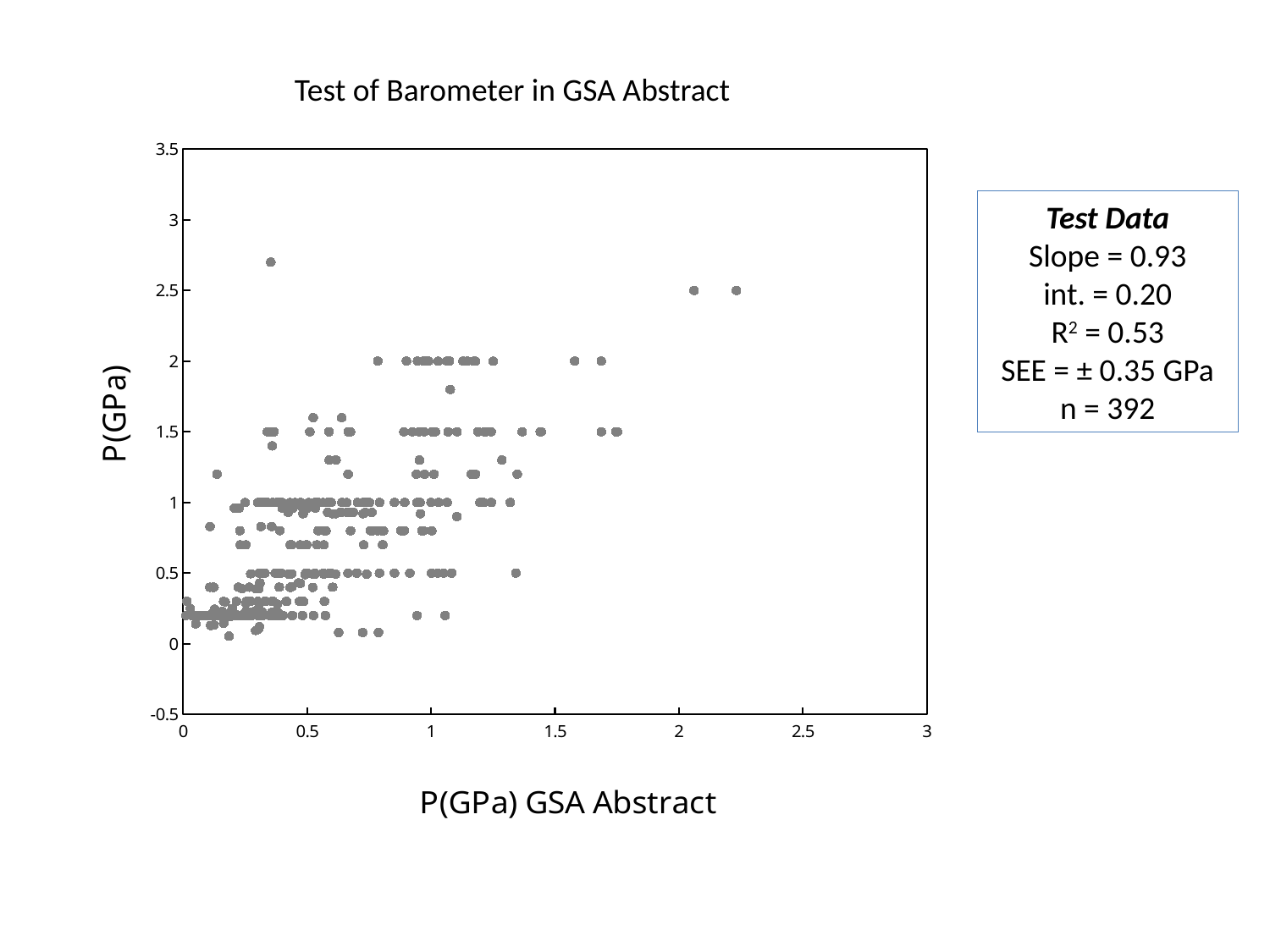
Is the highest P(GPa) value plotted on the y axis greater or less than 2.5? greater What SEE value is reported in the Test Data box? ± 0.35 GPa What intercept (int.) is reported in the Test Data box? 0.20 Is the largest P(GPa) GSA Abstract value plotted on the x axis greater or less than 2.5? less What kind of chart is shown on the slide? Scatter chart Do the P(GPa) values generally rise or fall as P(GPa) GSA Abstract increases along the x axis? rise How many data points (n) does the Test Data box say are plotted? 392 What is the label of the x axis? P(GPa) GSA Abstract What is the title of the chart? Test of Barometer in GSA Abstract What R² value is reported in the Test Data box? 0.53 What slope is reported in the Test Data box? 0.93 What is the highest tick value shown on the y axis? 3.5